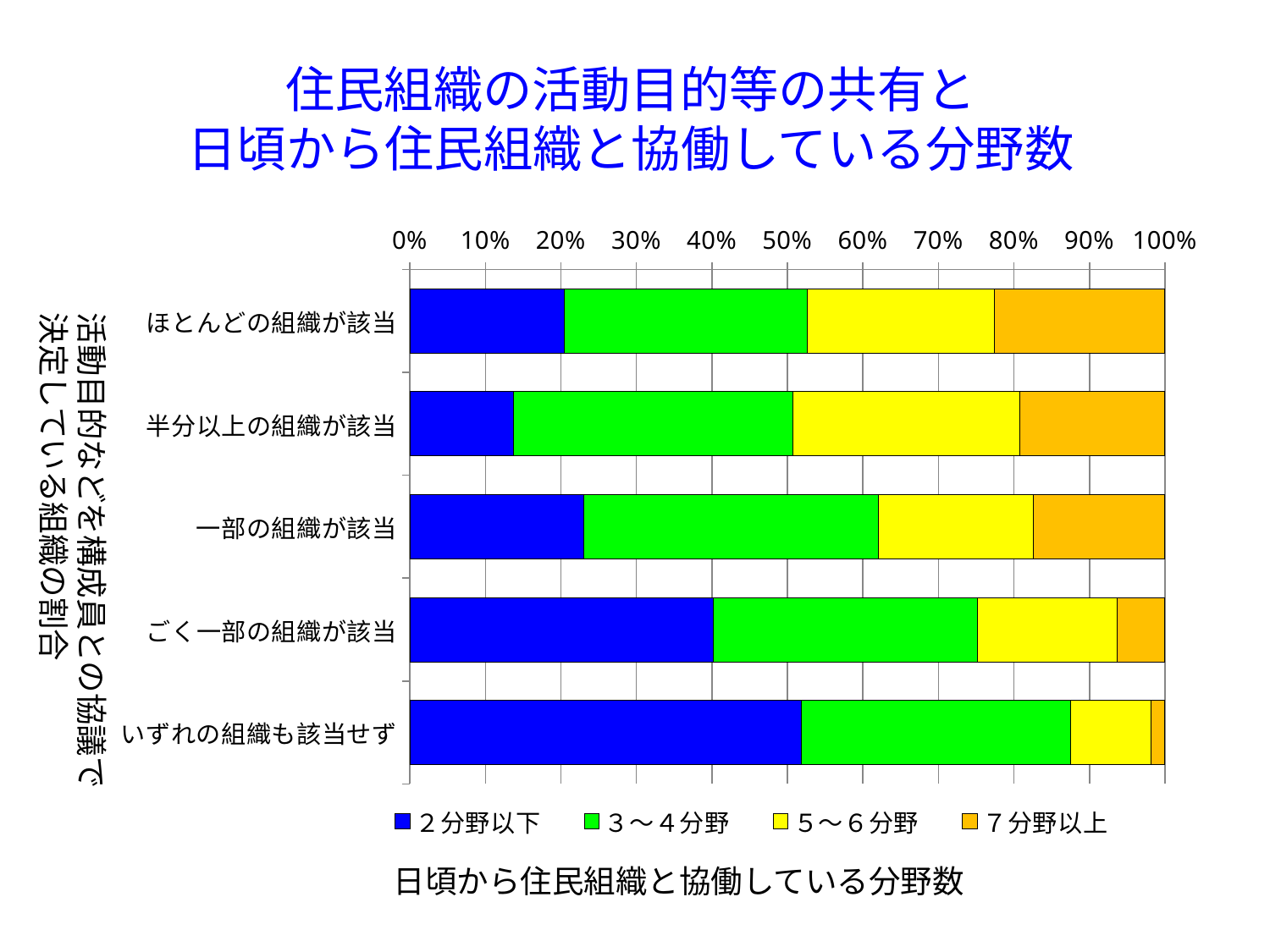
Which category has the smallest share for 2分野以下? 半分以上の組織が該当 Which category has the largest share for 2分野以下? いずれの組織も該当せず Which category has the larger share for 7分野以上: ほとんどの組織が該当 or ごく一部の組織が該当? ほとんどの組織が該当 How many categories are plotted on the vertical axis of the chart? 5 Which category has the larger share for 2分野以下: ほとんどの組織が該当 or いずれの組織も該当せず? いずれの組織も該当せず What is the label of the horizontal axis below the legend? 日頃から住民組織と協働している分野数 Which legend entry is shown in orange? 7分野以上 Is the share of 2分野以下 for ごく一部の組織が該当 greater or less than 30%? greater Is the share of 2分野以下 for 半分以上の組織が該当 greater or less than 20%? less Is the share of 2分野以下 for いずれの組織も該当せず greater or less than 40%? greater How many series does the chart's legend list? 4 What kind of chart is shown on the slide? stacked bar chart